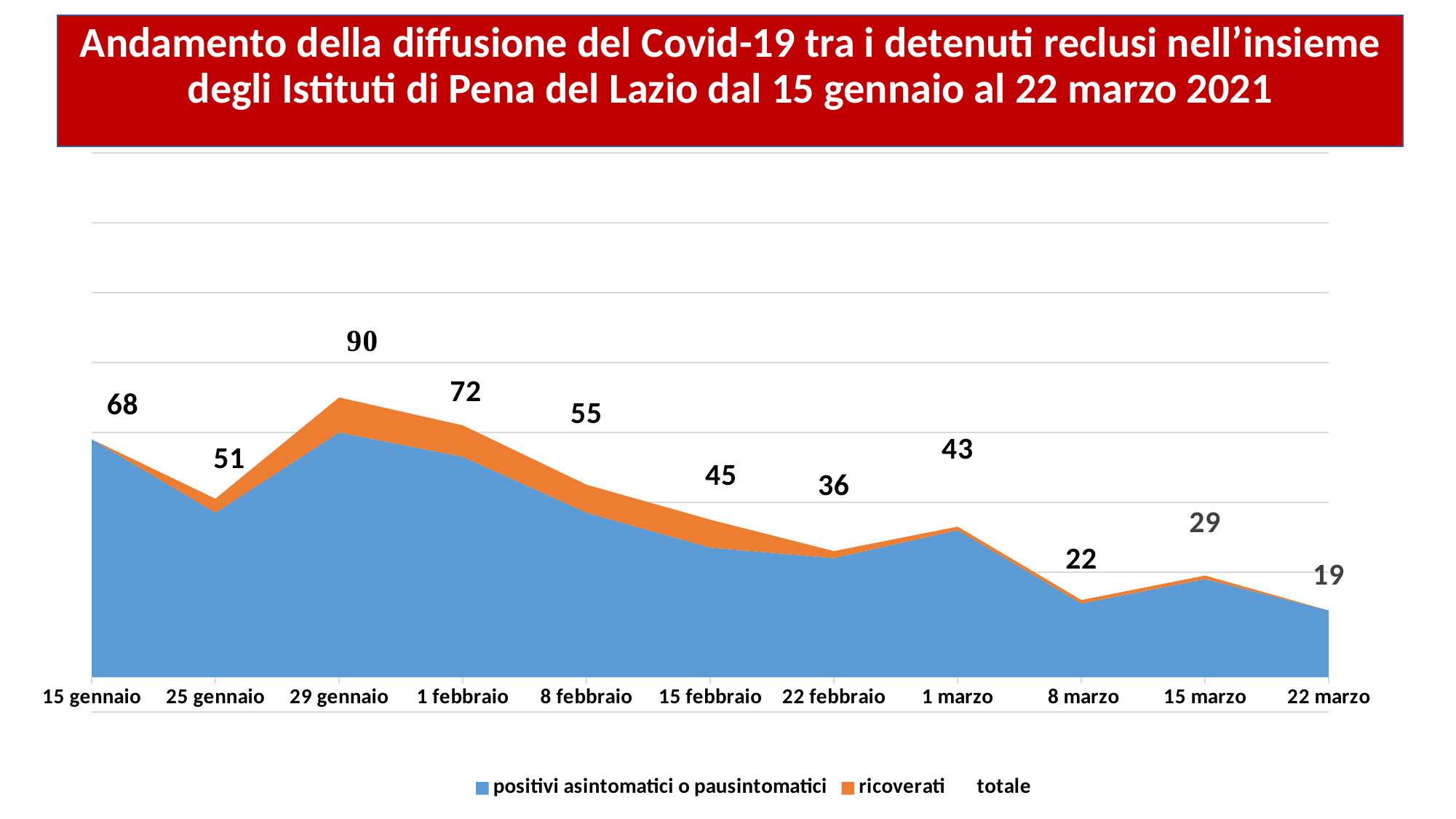
Which date has a larger 'totale' value, 8 marzo or 15 marzo? 15 marzo What is the difference between the 'totale' values for 29 gennaio and 1 febbraio? 18 What is the value of the 'totale' label for 1 marzo? 43 Do the 'totale' values generally rise or fall from 29 gennaio to 22 marzo? fall What kind of chart is shown on the slide? area chart On which date is the 'totale' value lowest? 22 marzo How many series does the legend list? 3 What is the value of the 'totale' label for 22 marzo? 19 How many dates are shown on the x axis? 11 What is the value of the 'totale' label for 29 gennaio? 90 What is the value of the 'totale' label for 15 gennaio? 68 On which date is the 'totale' value highest? 29 gennaio